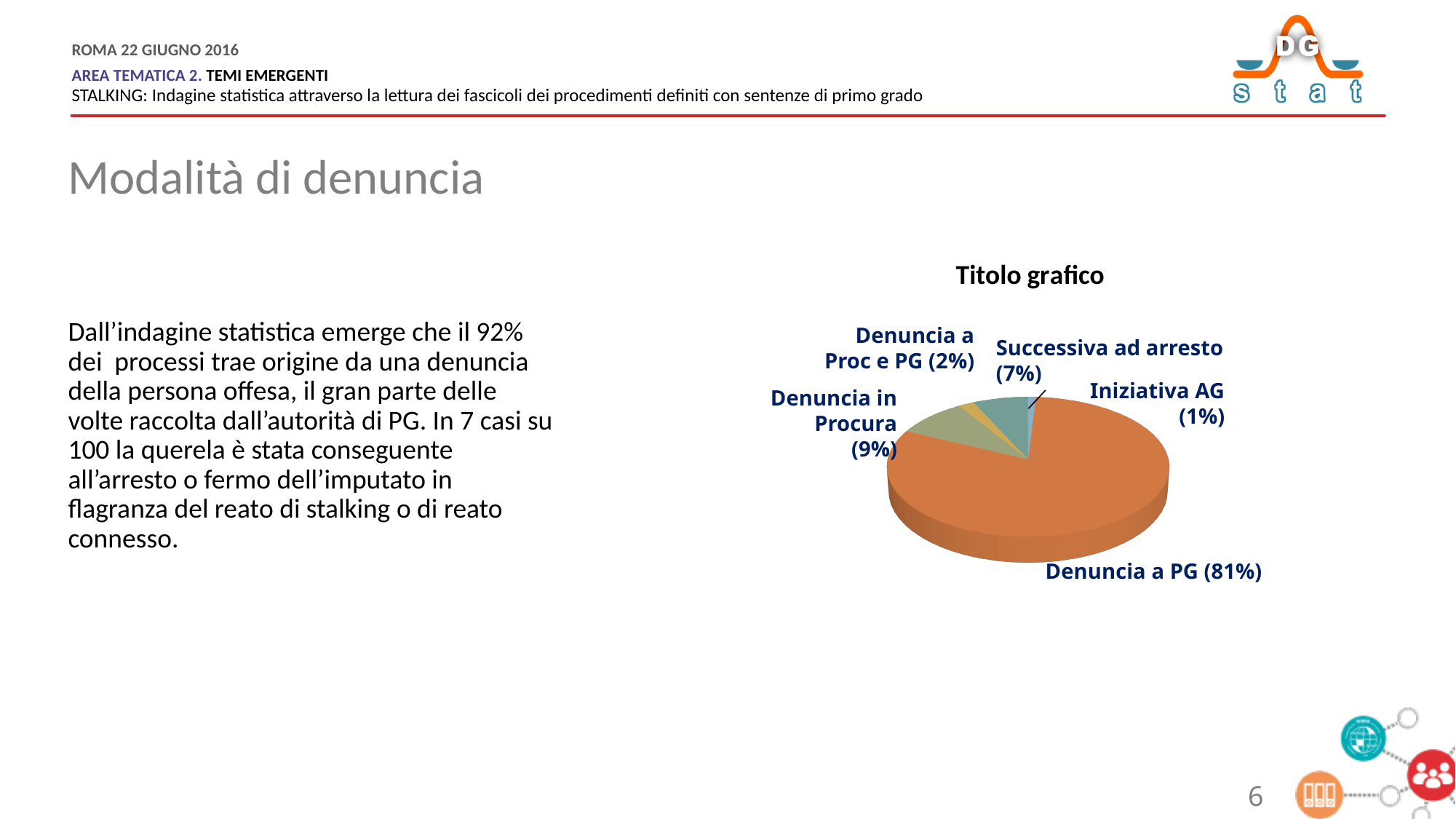
What share of the pie does Denuncia a PG represent? 81% Which is larger, the share for Denuncia in Procura or the share for Successiva ad arresto? Denuncia in Procura Which category has the largest slice of the pie? Denuncia a PG What share of the pie does Denuncia in Procura represent? 9% What kind of chart is shown on the slide? pie chart What is the title of the chart? Titolo grafico How many slices does the pie chart have? 5 What share of the pie does Iniziativa AG represent? 1% Which category has the smallest slice of the pie? Iniziativa AG What is the difference in percentage points between Denuncia a PG and Denuncia in Procura? 72